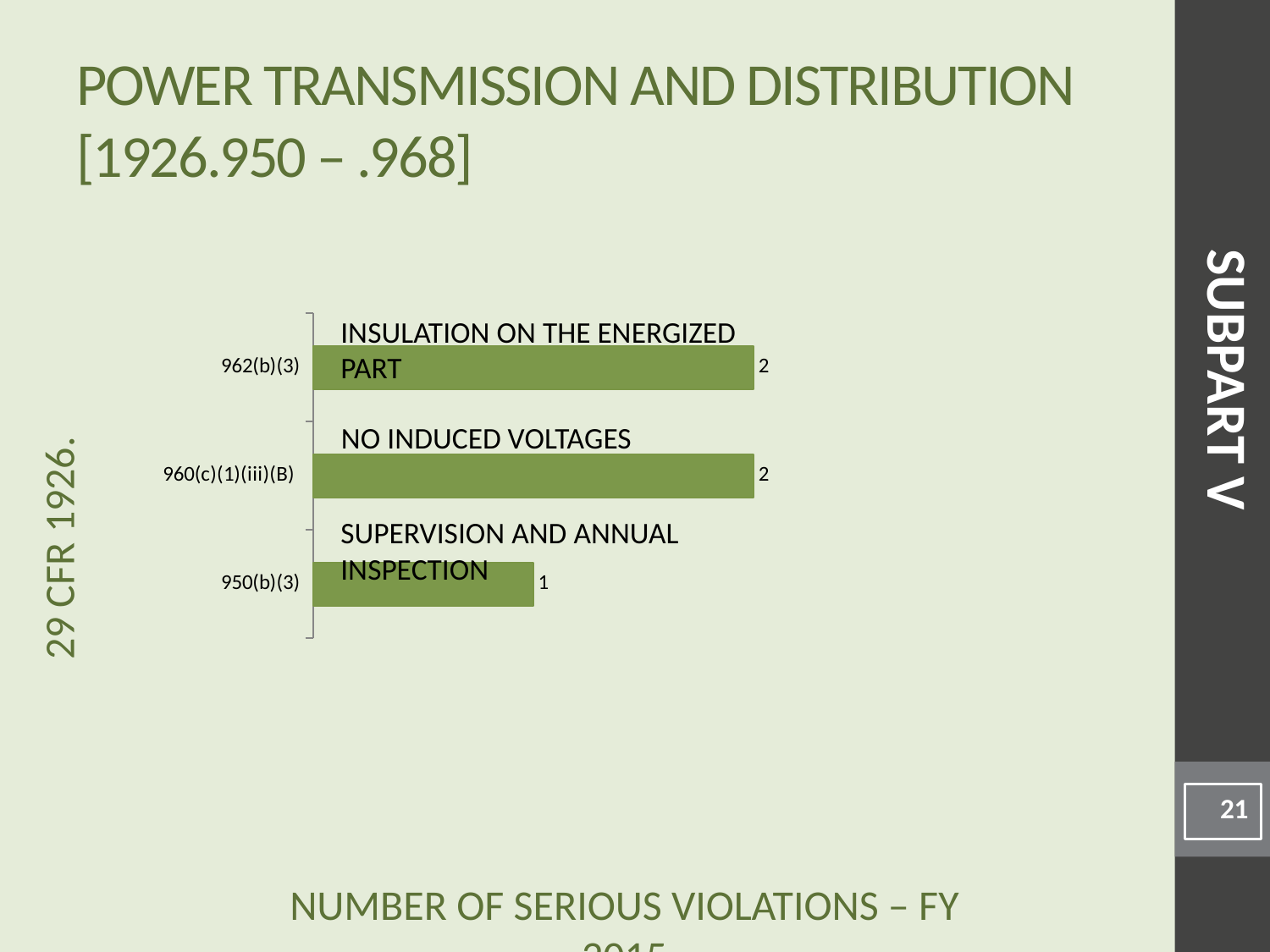
What is the number of serious violations for 950(b)(3)? 1 What kind of chart is shown on the slide? Bar chart What description is printed on the bar for 960(c)(1)(iii)(B)? NO INDUCED VOLTAGES What is the difference between the values for 962(b)(3) and 950(b)(3)? 1 Which category has the lowest number of serious violations? 950(b)(3) Which is larger, the value for 960(c)(1)(iii)(B) or the value for 950(b)(3)? 960(c)(1)(iii)(B) What is the y-axis label of the chart? 29 CFR 1926. What is the total number of serious violations across all three categories? 5 What is the number of serious violations for 962(b)(3)? 2 How many categories are shown in the chart? 3 What is the number of serious violations for 960(c)(1)(iii)(B)? 2